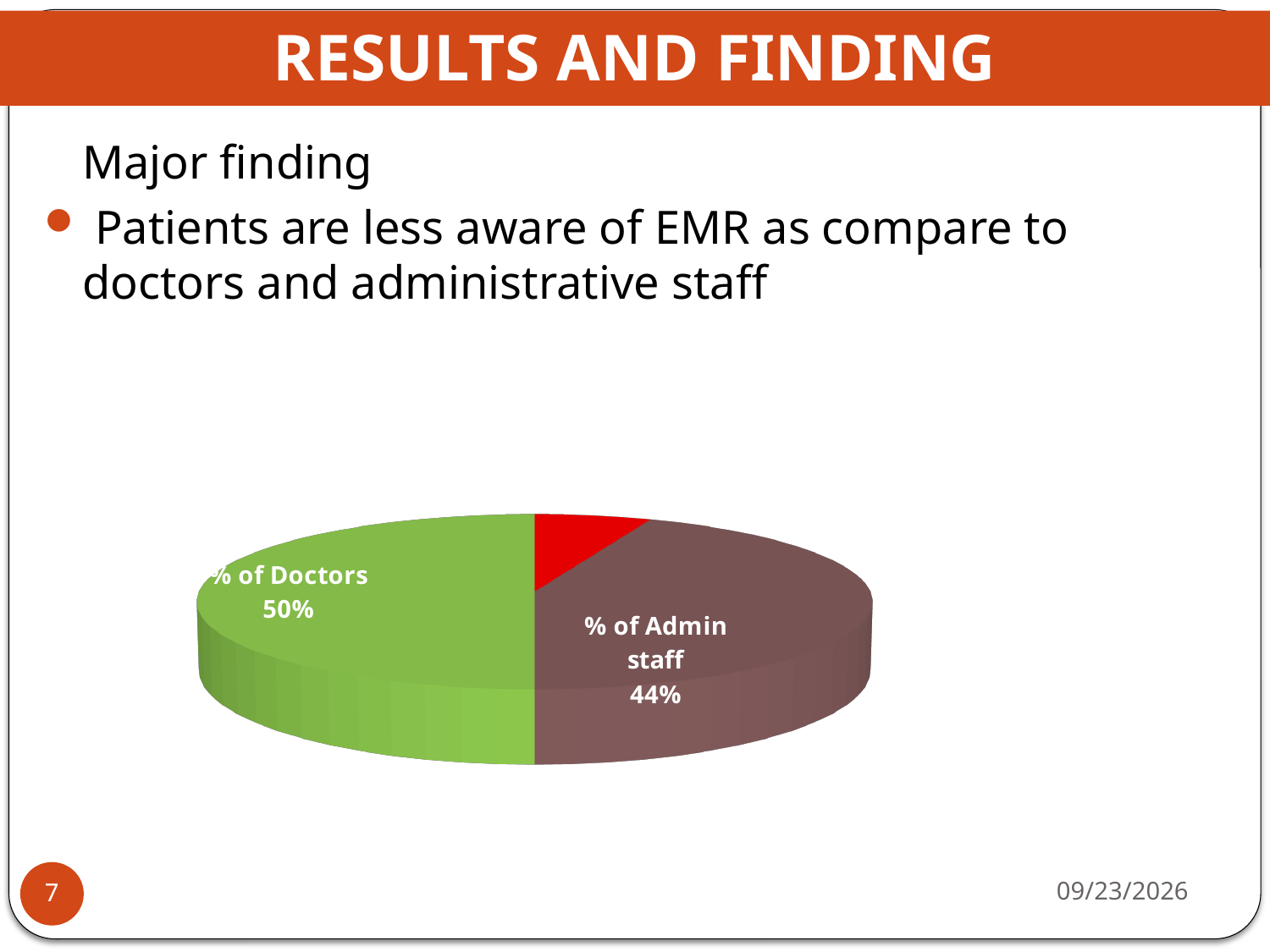
Which labelled slice of the pie is the largest? % of Doctors Which is larger, the % of Doctors slice or the % of Admin staff slice? % of Doctors How many slices does the pie chart have? 3 What kind of chart is shown on the slide? pie chart What is the value shown for the % of Doctors slice? 50% What is the value shown for the % of Admin staff slice? 44% What is the difference between the % of Doctors value and the % of Admin staff value? 6% What colour is the % of Doctors slice? green What colour is the % of Admin staff slice? brown